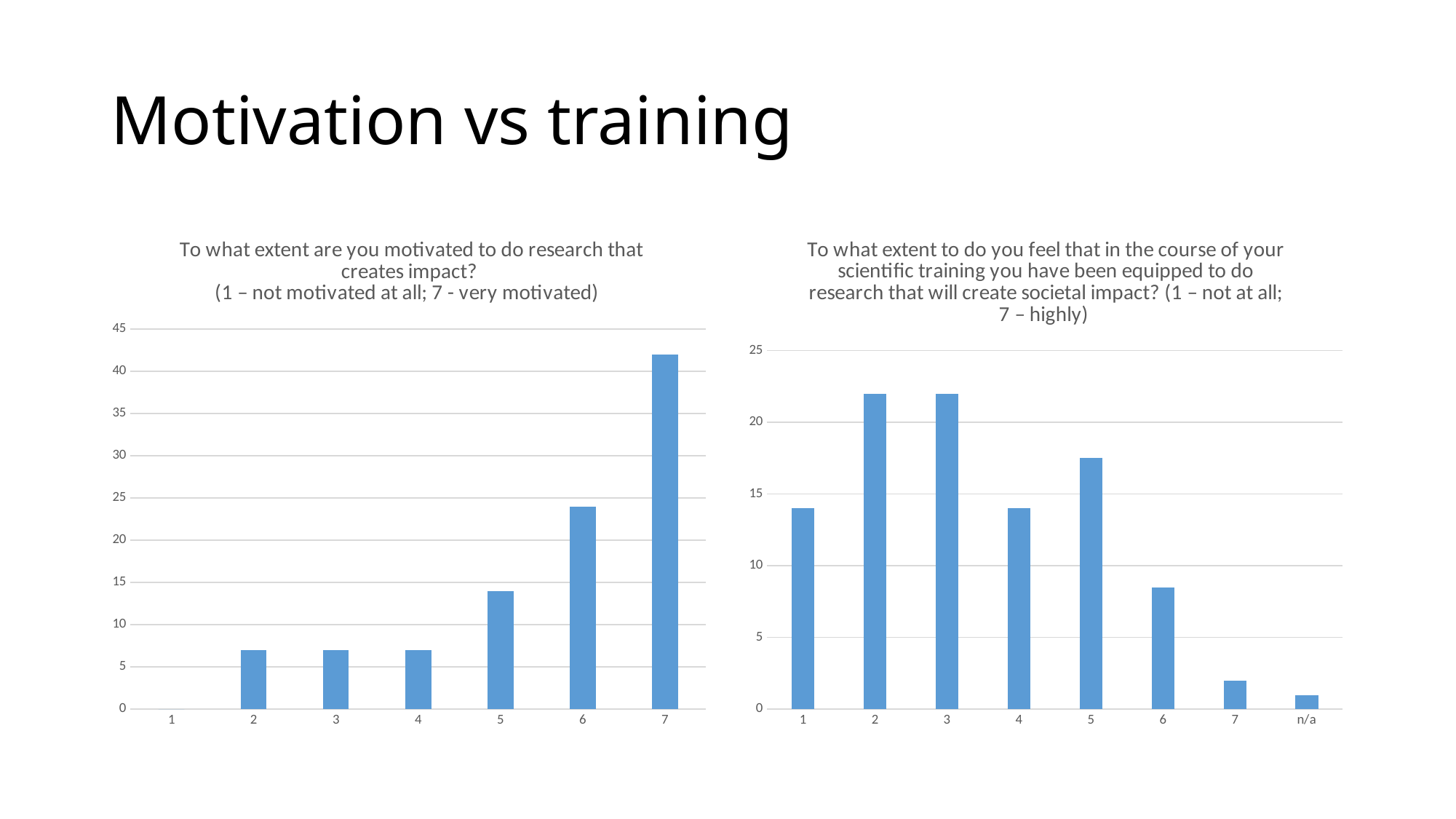
What kind of chart is the left chart about motivation to do research that creates impact? bar chart In the left chart (motivation to do research that creates impact), which rating has the lowest count? 1 In the right chart (scientific training equipping for societal impact), is the value for rating 5 greater or less than 15? greater In the left chart (motivation to do research that creates impact), is the value for rating 7 greater or less than 40? greater In the left chart (motivation to do research that creates impact), do the values generally rise or fall as the rating increases from 1 to 7? rise In the left chart (motivation to do research that creates impact), which rating has the highest count? 7 How many categories are shown on the x axis of the right chart (scientific training equipping for societal impact)? 8 In the left chart (motivation to do research that creates impact), is the value for rating 6 greater or less than 25? less How many rating categories are shown on the x axis of the left chart (motivation to do research that creates impact)? 7 In the right chart (scientific training equipping for societal impact), which has the larger value: rating 2 or rating 4? 2 In the right chart (scientific training equipping for societal impact), which has the larger value: rating 1 or rating 6? 1